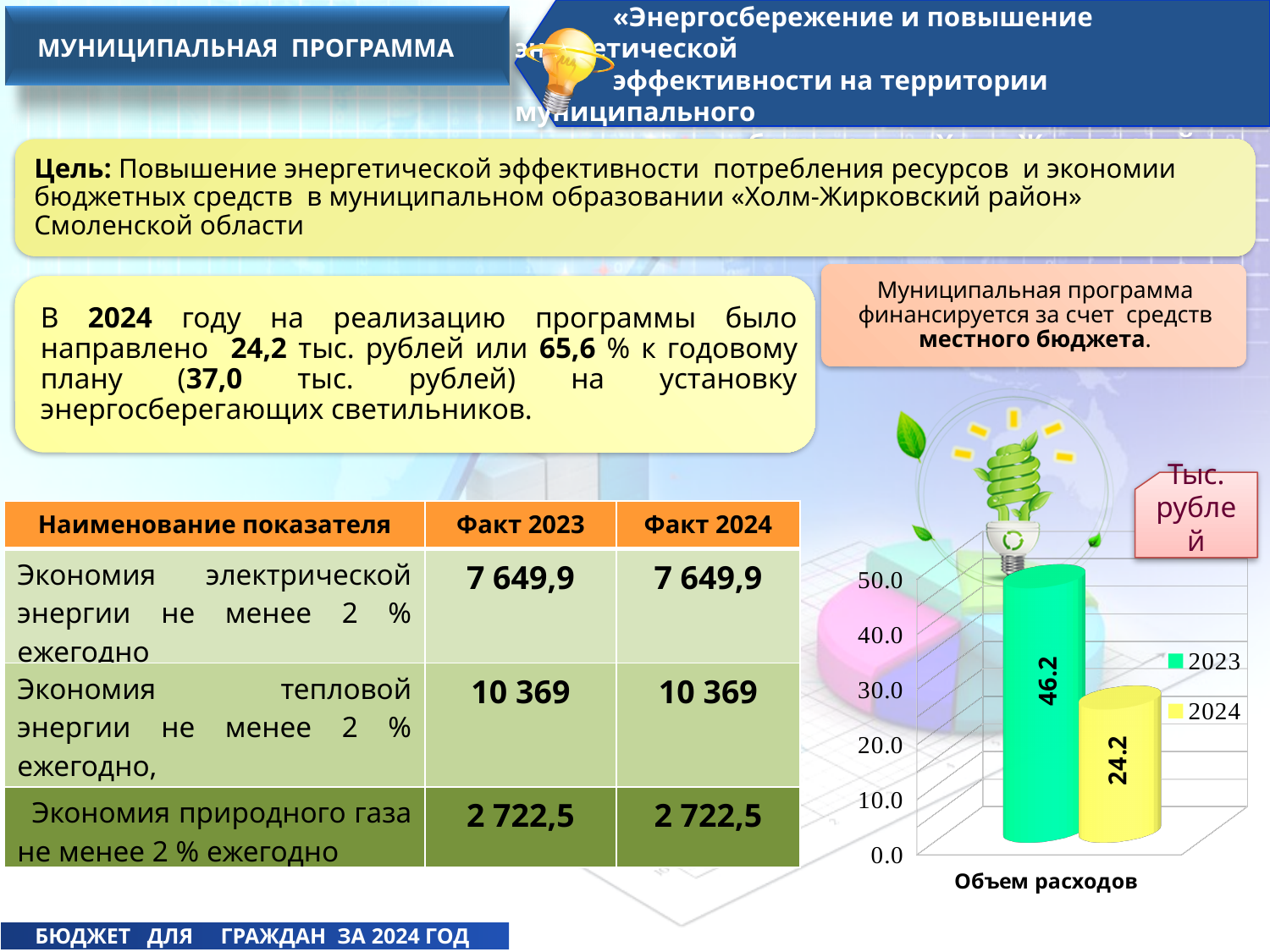
What is the difference between the 2023 and 2024 values in the chart? 22.0 Which series has the higher value in the chart, 2023 or 2024? 2023 What is the value for 2023 in the chart? 46.2 What is the highest tick value shown on the chart's vertical axis? 50.0 What is the category label shown below the chart's bars? Объем расходов Is the value for 2024 greater or less than 30.0? less What is the value for 2024 in the chart? 24.2 Which series is shown in yellow in the chart? 2024 Is the value for 2023 greater or less than 40.0? greater How many series does the chart legend list? 2 What kind of chart is shown on the slide? bar chart Which series has the lowest value in the chart? 2024